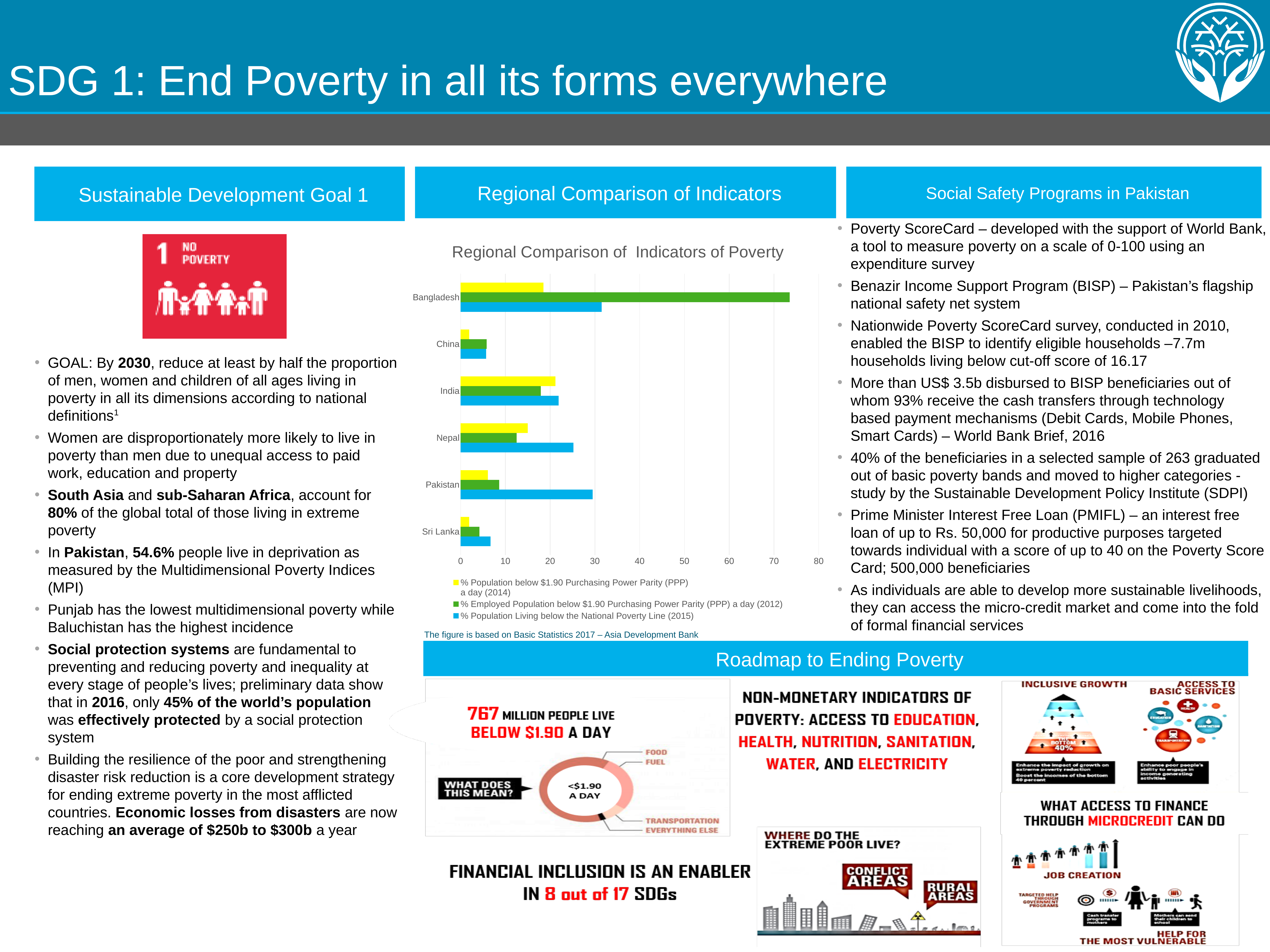
Is the value for Pakistan in the % Population Living below the National Poverty Line (2015) series greater or less than 20? greater Which country has the highest value for % Population Living below the National Poverty Line (2015)? Bangladesh How many countries are shown on the Regional Comparison of Indicators of Poverty chart? 6 For Pakistan, which is larger: % Population Living below the National Poverty Line (2015) or % Population below $1.90 PPP a day (2014)? % Population Living below the National Poverty Line (2015) What is the title of the chart in the Regional Comparison of Indicators section? Regional Comparison of Indicators of Poverty Is the value for Bangladesh in the % Employed Population below $1.90 PPP a day (2012) series greater or less than 70? greater Is the value for Nepal in the % Population below $1.90 PPP a day (2014) series greater or less than 20? less How many series does the legend of the Regional Comparison of Indicators of Poverty chart list? 3 What kind of chart is the Regional Comparison of Indicators of Poverty chart? bar chart Which country has the lowest value for % Employed Population below $1.90 PPP a day (2012)? Sri Lanka Which country has the highest value for % Employed Population below $1.90 Purchasing Power Parity (PPP) a day (2012)? Bangladesh